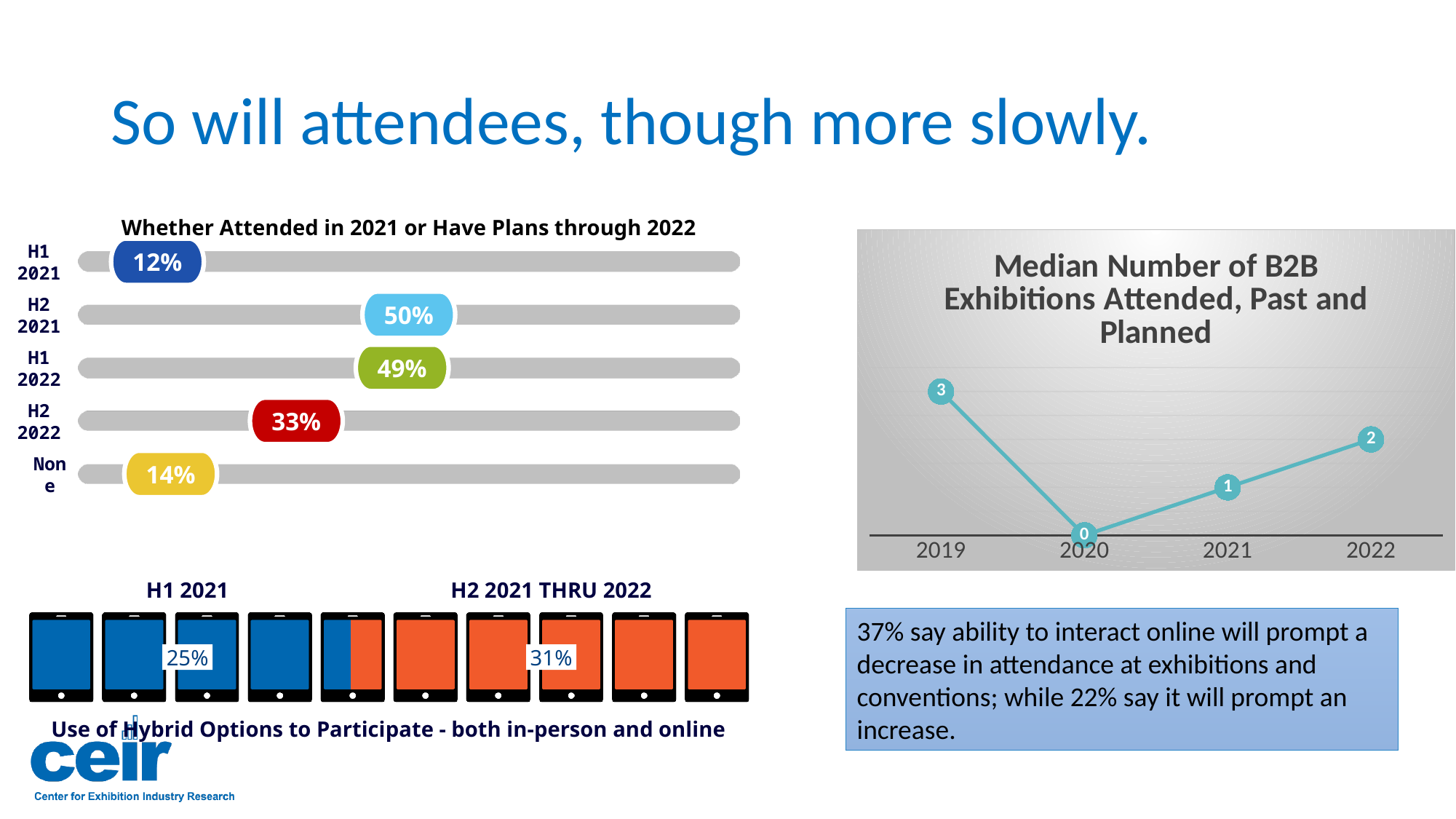
In the chart 'Whether Attended in 2021 or Have Plans through 2022', what is the value for H2 2022? 33% In the chart 'Whether Attended in 2021 or Have Plans through 2022', how many categories are shown? 5 What kind of chart is 'Whether Attended in 2021 or Have Plans through 2022'? Bar chart In the chart 'Whether Attended in 2021 or Have Plans through 2022', what is the value for H2 2021? 50% In the chart 'Whether Attended in 2021 or Have Plans through 2022', which category has the lowest value? H1 2021 In the 'Use of Hybrid Options to Participate' graphic at the bottom left, what is the value for H2 2021 THRU 2022? 31% In the chart 'Median Number of B2B Exhibitions Attended, Past and Planned', which year has the lowest value? 2020 In the chart 'Median Number of B2B Exhibitions Attended, Past and Planned', what is the value for 2019? 3 In the chart 'Whether Attended in 2021 or Have Plans through 2022', which category has the highest value? H2 2021 In the chart 'Whether Attended in 2021 or Have Plans through 2022', what is the difference between the values for H1 2022 and H2 2022? 16% What kind of chart is 'Median Number of B2B Exhibitions Attended, Past and Planned'? Line chart In the chart 'Median Number of B2B Exhibitions Attended, Past and Planned', do the values rise or fall from 2020 to 2022? Rise